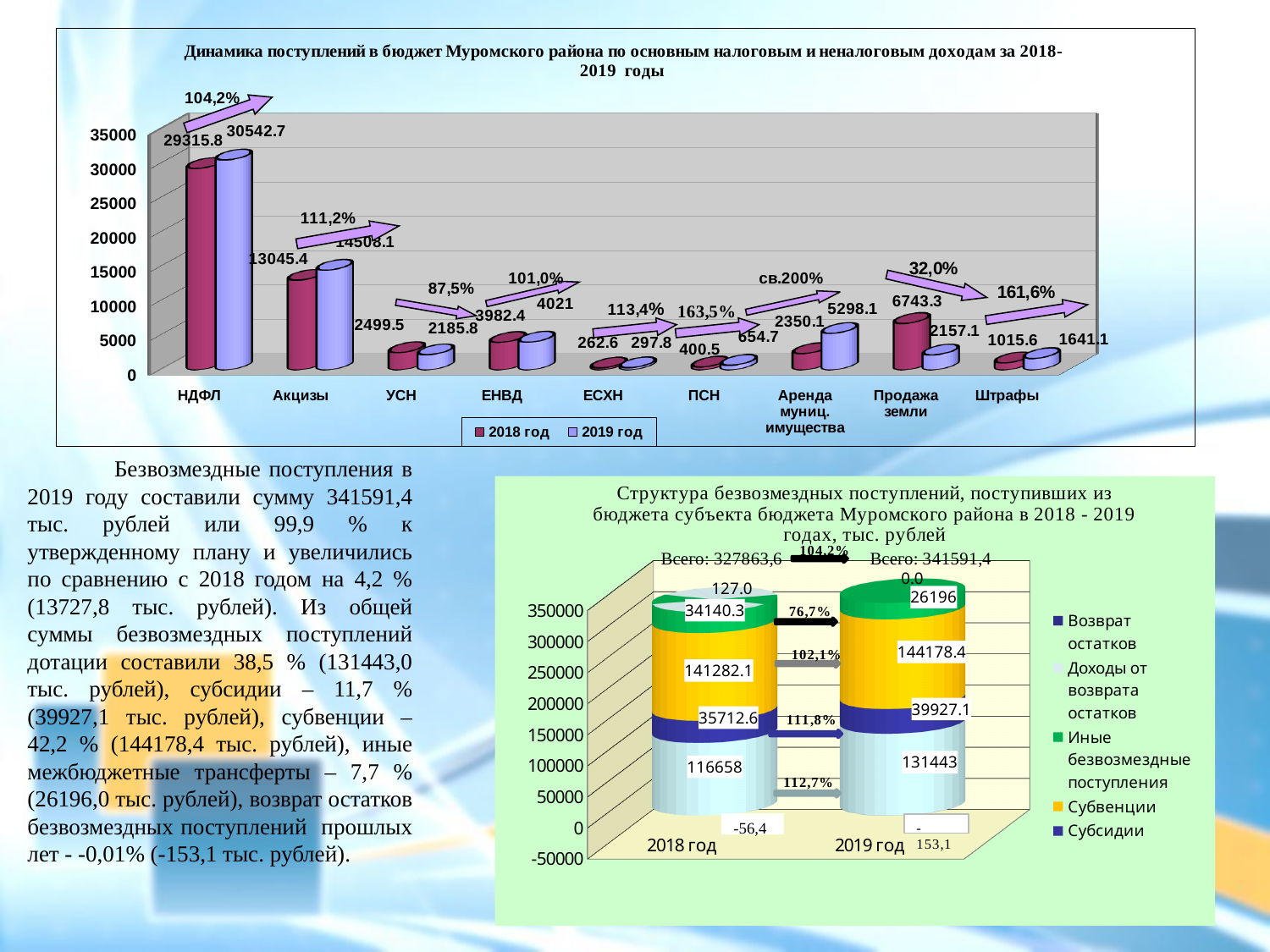
What type of chart is the top chart on the slide? Bar chart In the bottom chart, what is the total shown for 2018 год? 327863,6 In the top chart, how many categories are shown on the x axis? 9 In the top chart, which category has the highest value for 2018 год? НДФЛ In the top chart, how many series does the legend list? 2 In the bottom chart 'Структура безвозмездных поступлений', what is the value of Субвенции for 2019 год? 144178.4 In the top chart 'Динамика поступлений в бюджет Муромского района', what is the value for НДФЛ in 2019 год? 30542.7 In the top chart, what is the value for Акцизы in 2018 год? 13045.4 In the top chart, which category has the lowest value for 2019 год? ЕСХН In the top chart, what is the value for Продажа земли in 2019 год? 2157.1 In the top chart, which is larger for Продажа земли: the 2018 год value or the 2019 год value? 2018 год In the top chart, what is the difference between the 2019 год and 2018 год values for Аренда муниц. имущества? 2948